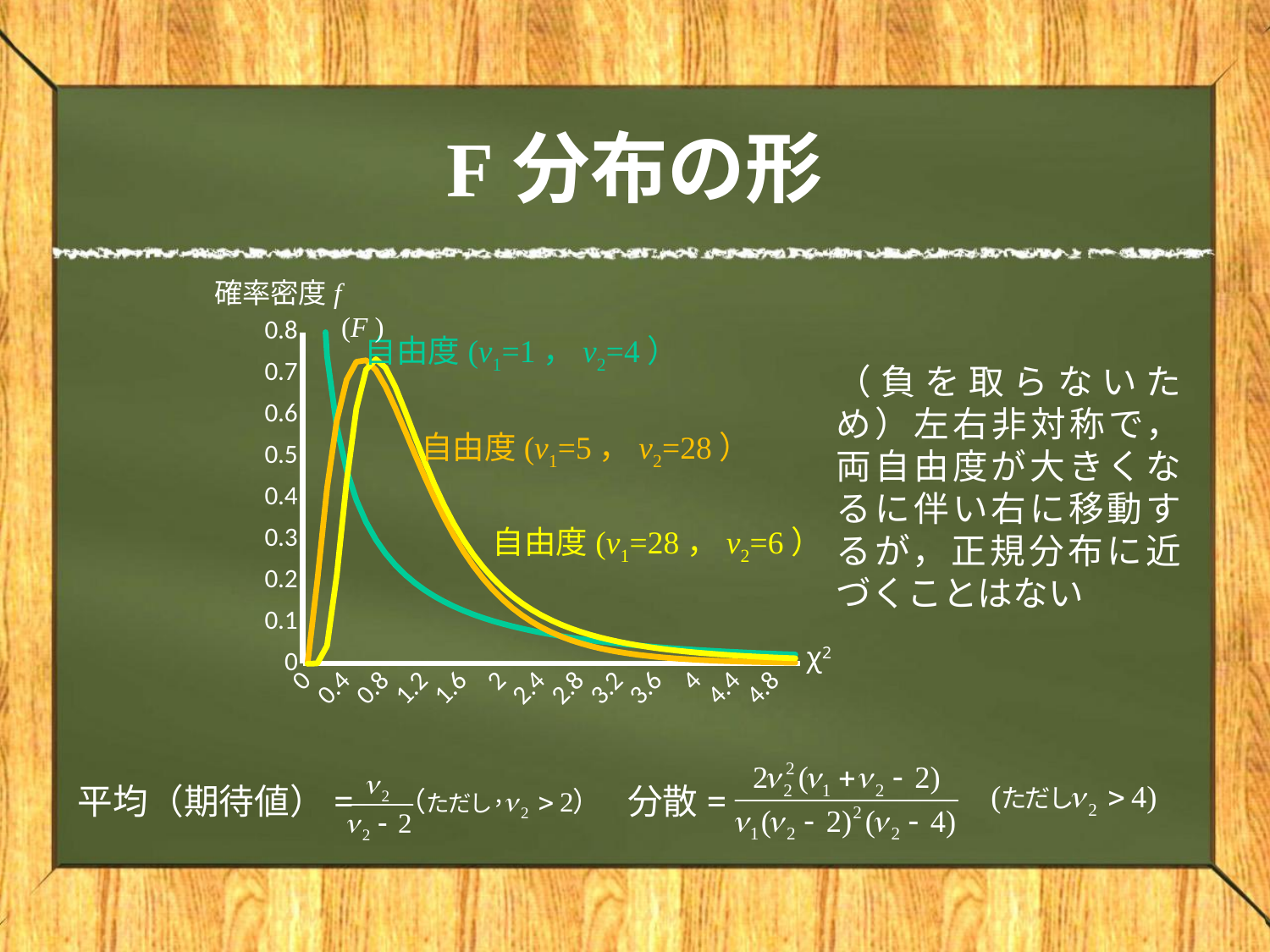
Is the value of the curve for 自由度 (v1=1, v2=4) at x = 2.8 greater or less than 0.2? less Is the value of the curve for 自由度 (v1=5, v2=28) at x = 3.2 greater or less than 0.1? less Is the peak value of the curve for 自由度 (v1=5, v2=28) greater or less than 0.6? greater What colour is the curve for 自由度 (v1=1, v2=4)? green What kind of chart is shown on the slide? line chart Which curve reaches the highest value on the chart? 自由度 (v1=1, v2=4) How many tick labels are shown on the x-axis of the chart? 13 How many curves (series) are plotted on the chart? 3 What is the title of the slide containing the chart? F 分布の形 Does the curve for 自由度 (v1=1, v2=4) rise or fall as the x-axis value increases? fall